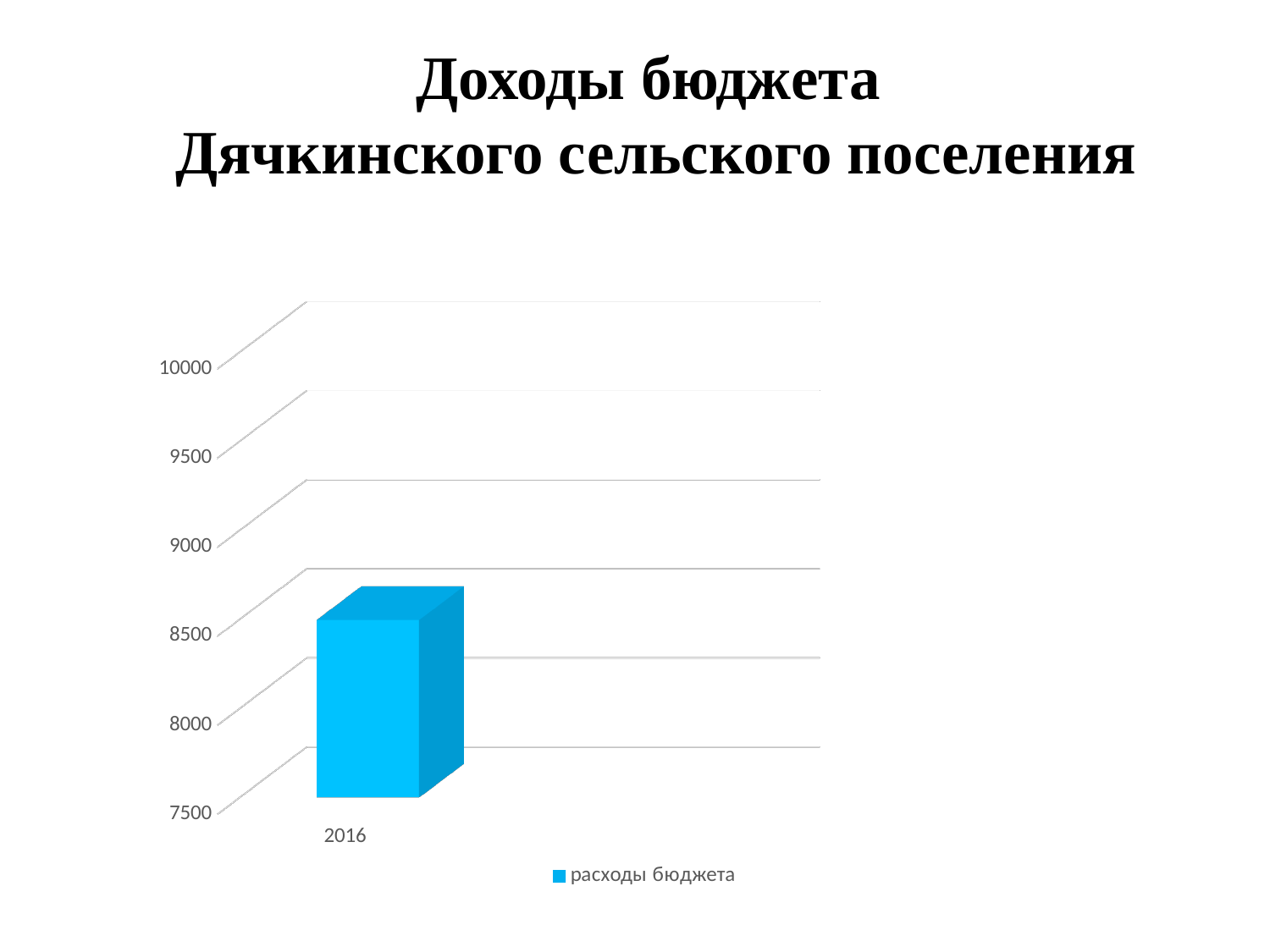
How many series does the legend list? 1 How many bars are plotted in the chart? 1 What kind of chart is shown on the slide? bar chart What is the series name shown in the legend? расходы бюджета What is the lowest value shown on the vertical axis? 7500 Is the value for 2016 greater or less than 10000? less What is the title of the slide above the chart? Доходы бюджета Дячкинского сельского поселения Is the value for 2016 greater or less than 9000? less Which year is shown on the x axis of the chart? 2016 Is the value for 2016 greater or less than 8000? greater